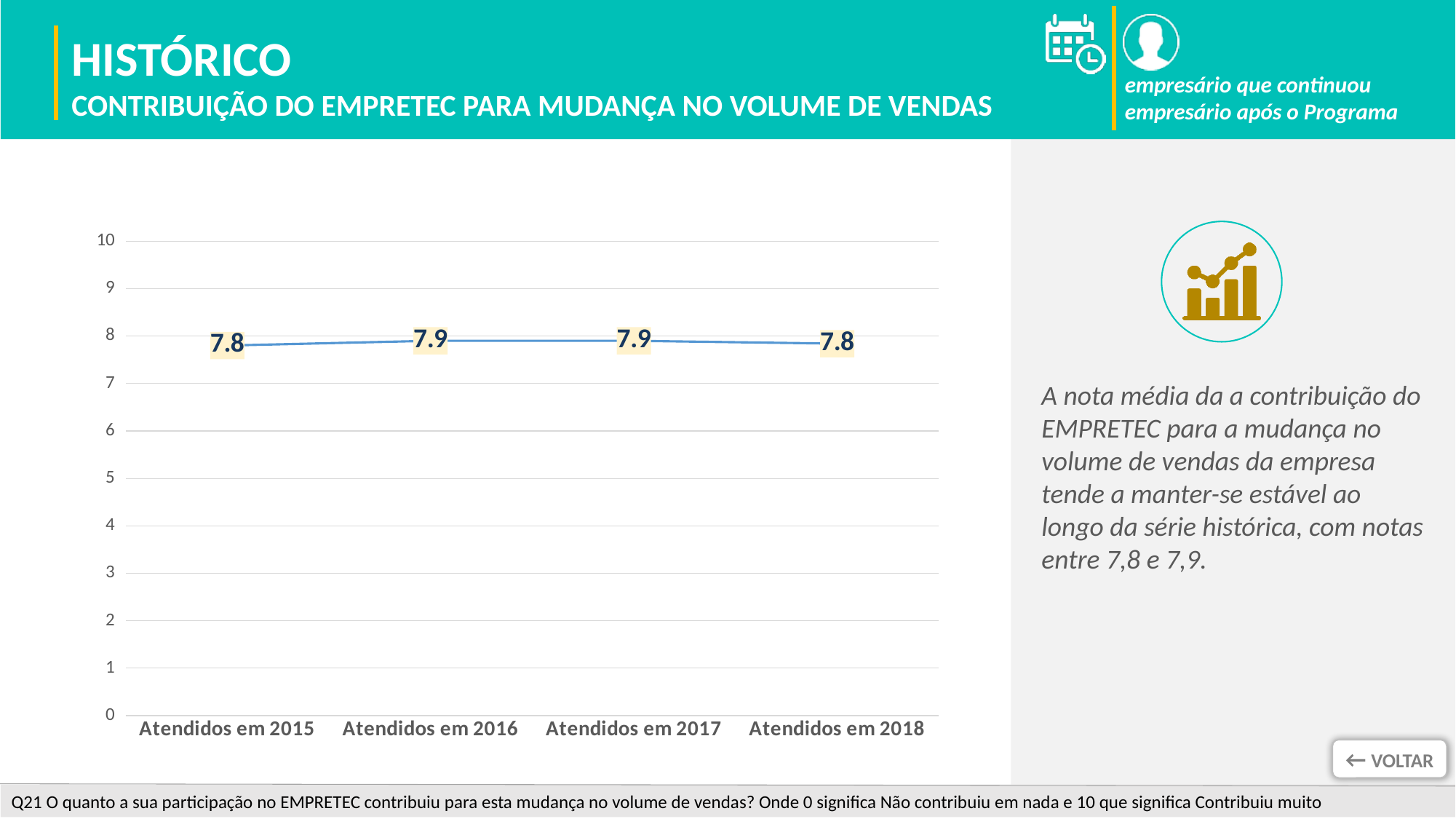
What is the difference between the values for Atendidos em 2016 and Atendidos em 2015? 0.1 What is the value for Atendidos em 2016? 7.9 What is the value for Atendidos em 2015? 7.8 Is the value for Atendidos em 2016 greater or less than 5? greater What kind of chart is shown on the slide? line chart Is the value for Atendidos em 2015 greater or less than 9? less What is the maximum value shown on the y axis of the chart? 10 Which is larger, the value for Atendidos em 2017 or the value for Atendidos em 2018? Atendidos em 2017 How many categories are shown on the x axis of the chart? 4 What is the value for Atendidos em 2017? 7.9 What is the value for Atendidos em 2018? 7.8 What is the label of the first category on the x axis? Atendidos em 2015